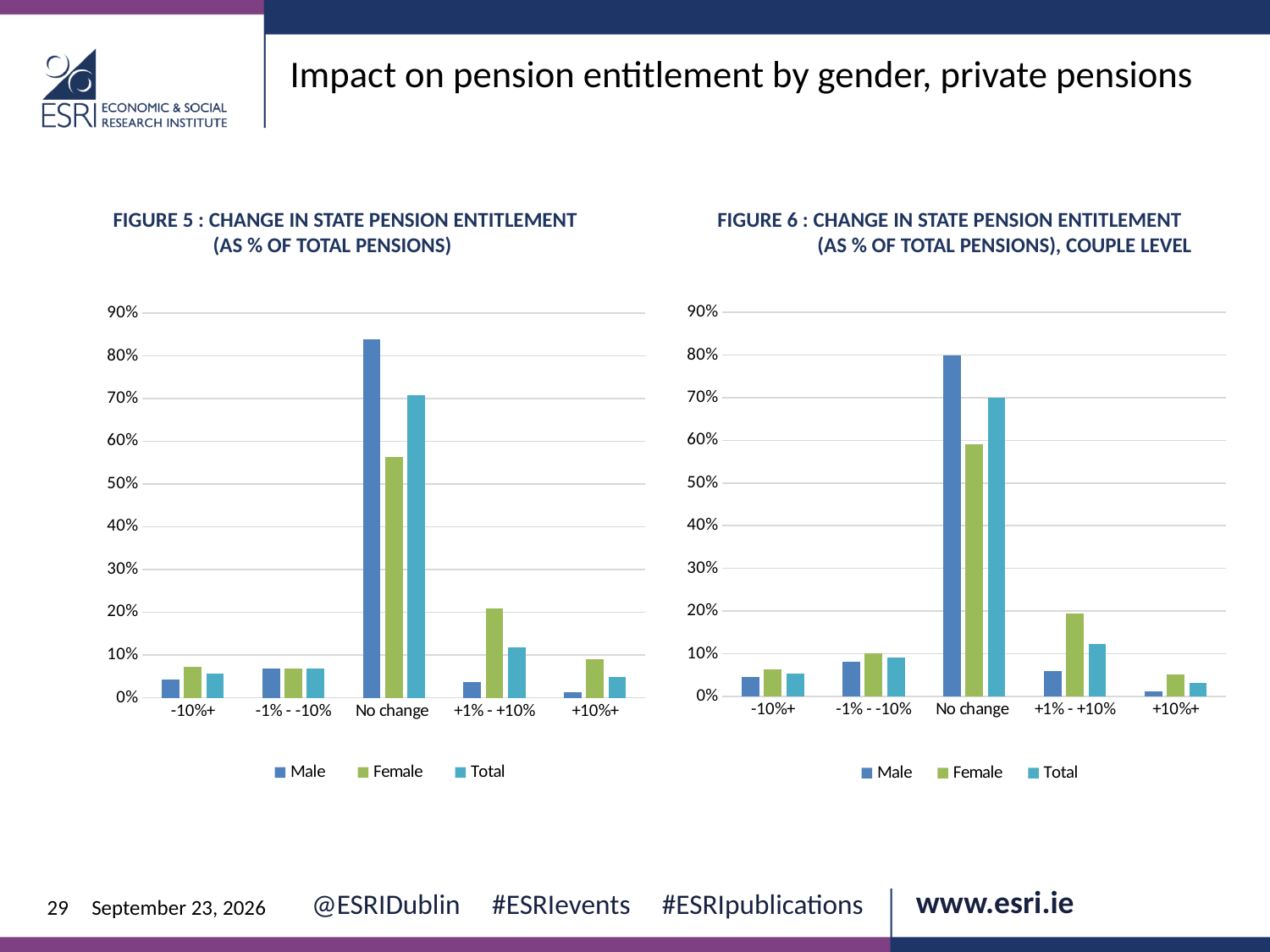
In Figure 6, is the Female value for No change greater or less than 50%? greater In Figure 5, is the Male value for No change greater or less than 80%? greater In Figure 6, is the Total value for No change greater or less than 60%? greater In Figure 5, which category has the lowest Male value? +10%+ In Figure 5, which category has the highest Male value? No change In Figure 6, which category has the highest Female value? No change What kind of chart is Figure 5? Bar chart In Figure 5, which is larger for the +1% - +10% category, the Male value or the Female value? Female How many series does the legend of Figure 6 list? 3 In Figure 5, how many categories are shown on the x axis? 5 In Figure 6, which is larger for the +1% - +10% category, the Female value or the Total value? Female